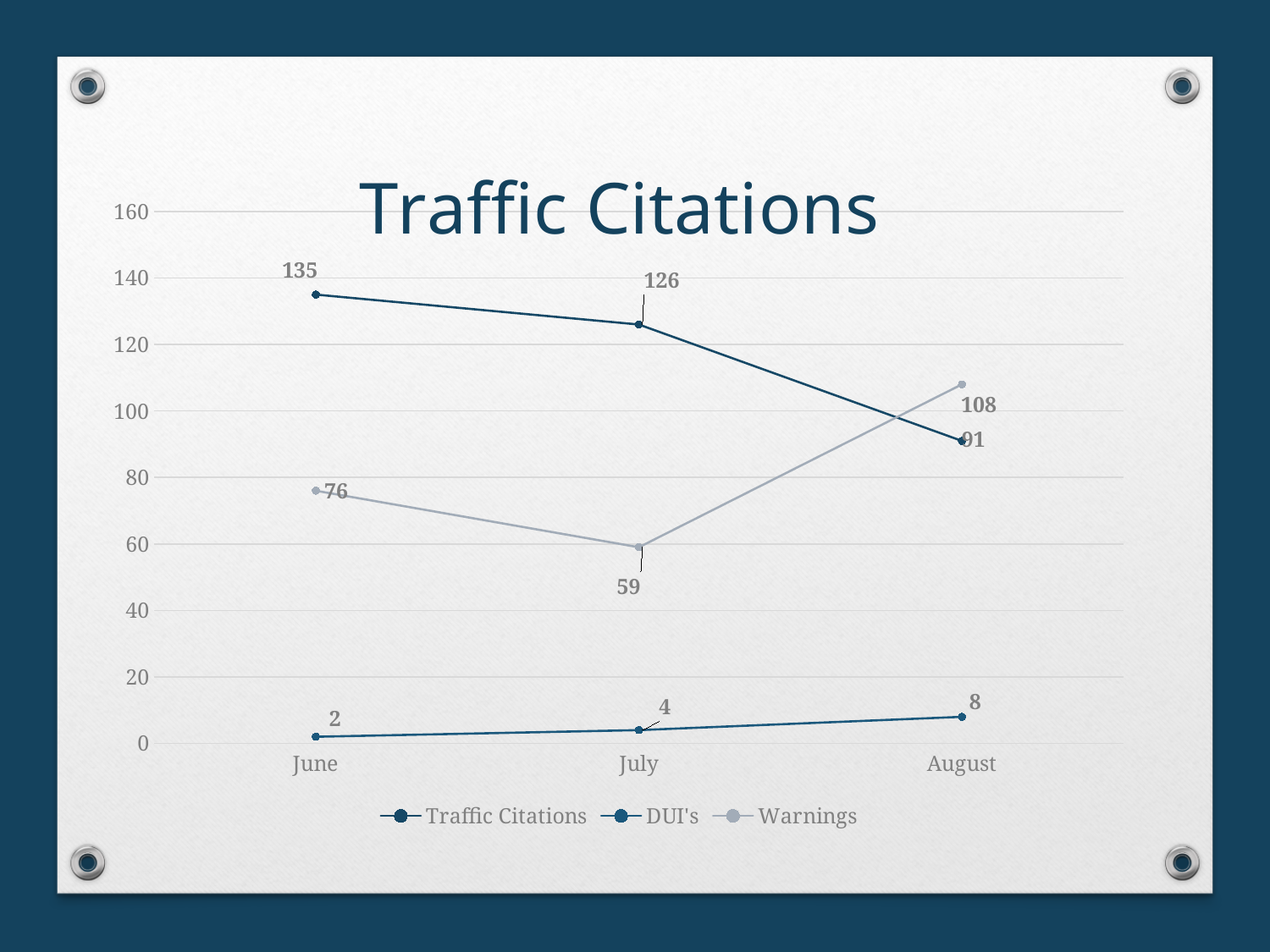
In which month is the Warnings value lowest? July Which is larger in August: Traffic Citations or Warnings? Warnings How many months are shown on the x axis? 3 In which month is the Traffic Citations value highest? June What kind of chart is shown on the slide? line chart What is the value for Traffic Citations in June? 135 What is the value for Warnings in August? 108 How many series does the legend list? 3 What is the value for Warnings in July? 59 What is the difference between the Traffic Citations values for June and July? 9 What is the value for DUI's in August? 8 Is the value for Warnings in June greater or less than 80? less